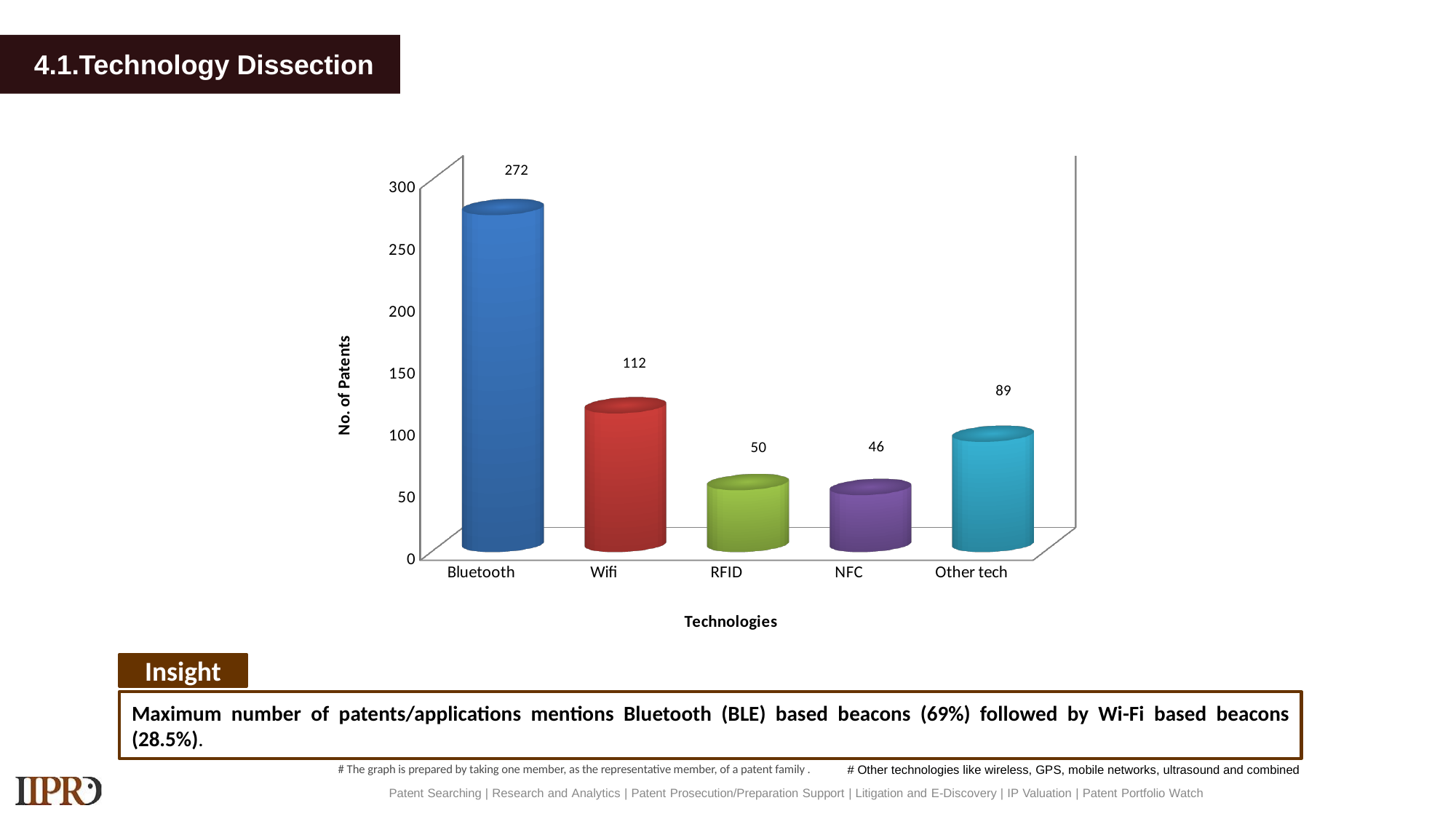
What is the difference in number of patents between Bluetooth and Wifi? 160 What is the number of patents for Bluetooth? 272 What is the label of the y axis? No. of Patents What is the difference in number of patents between RFID and NFC? 4 Which technology has the lowest number of patents? NFC What kind of chart is shown on the slide? Bar chart What is the number of patents for NFC? 46 How many technology categories are shown on the x axis? 5 What is the number of patents for Wifi? 112 Which technology has the highest number of patents? Bluetooth Which has more patents, Wifi or Other tech? Wifi What is the number of patents for Other tech? 89